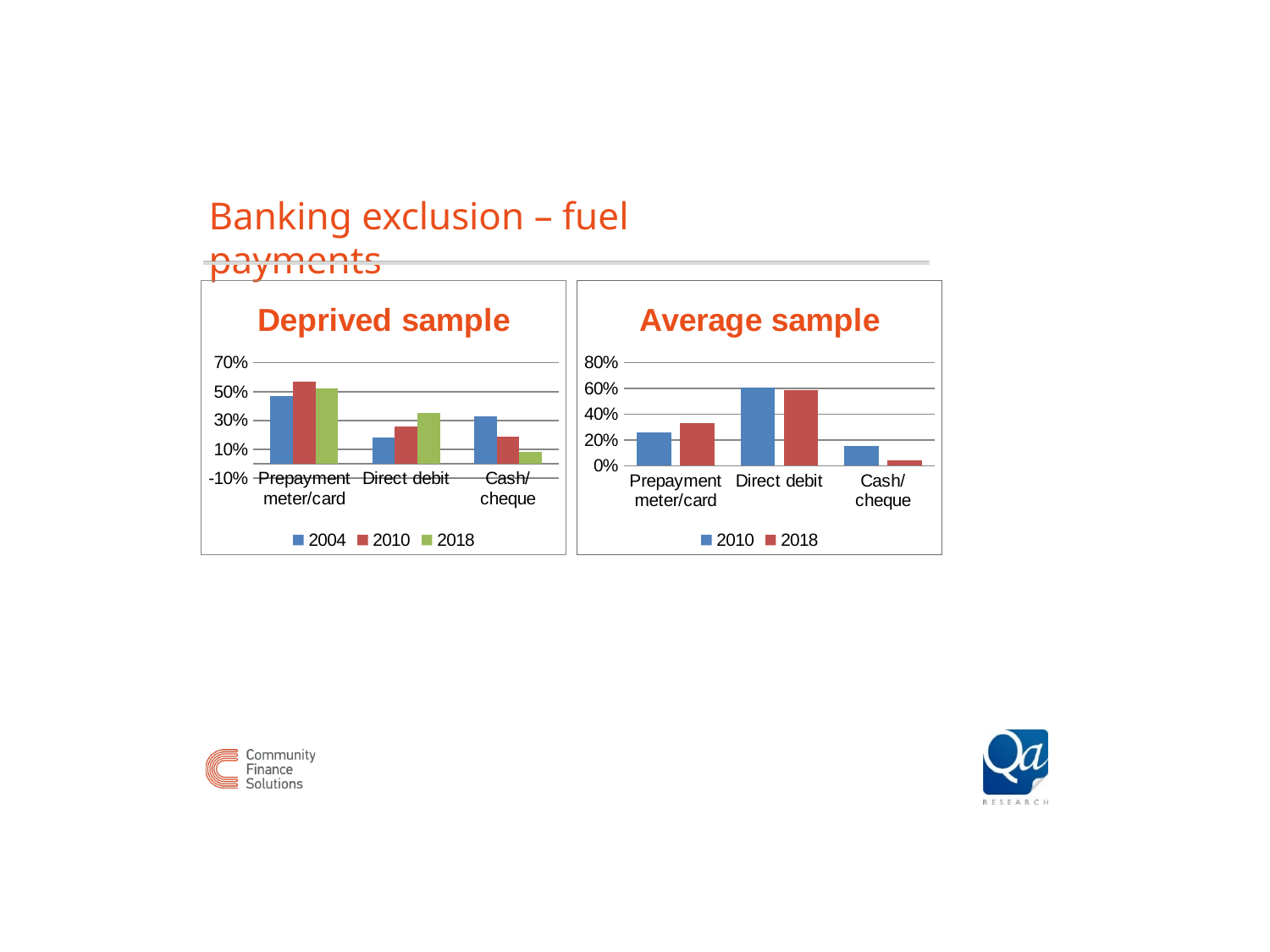
In the "Average sample" chart, is the 2018 value for Prepayment meter/card greater or less than 20%? greater How many series does the legend of the "Deprived sample" chart list? 3 Which series are listed in the legend of the "Average sample" chart? 2010 and 2018 In the "Deprived sample" chart, which category has the highest 2010 value? Prepayment meter/card In the "Average sample" chart, is the 2018 value for Cash/cheque greater or less than 20%? less In the "Deprived sample" chart, does the Direct debit value rise or fall from 2004 to 2018? rise What type of chart is the "Deprived sample" chart? bar chart In the "Deprived sample" chart, is the 2010 value for Prepayment meter/card greater or less than 50%? greater How many categories are shown on the x axis of the "Average sample" chart? 3 In the "Average sample" chart, which is larger for 2010: Direct debit or Cash/cheque? Direct debit How many series does the legend of the "Average sample" chart list? 2